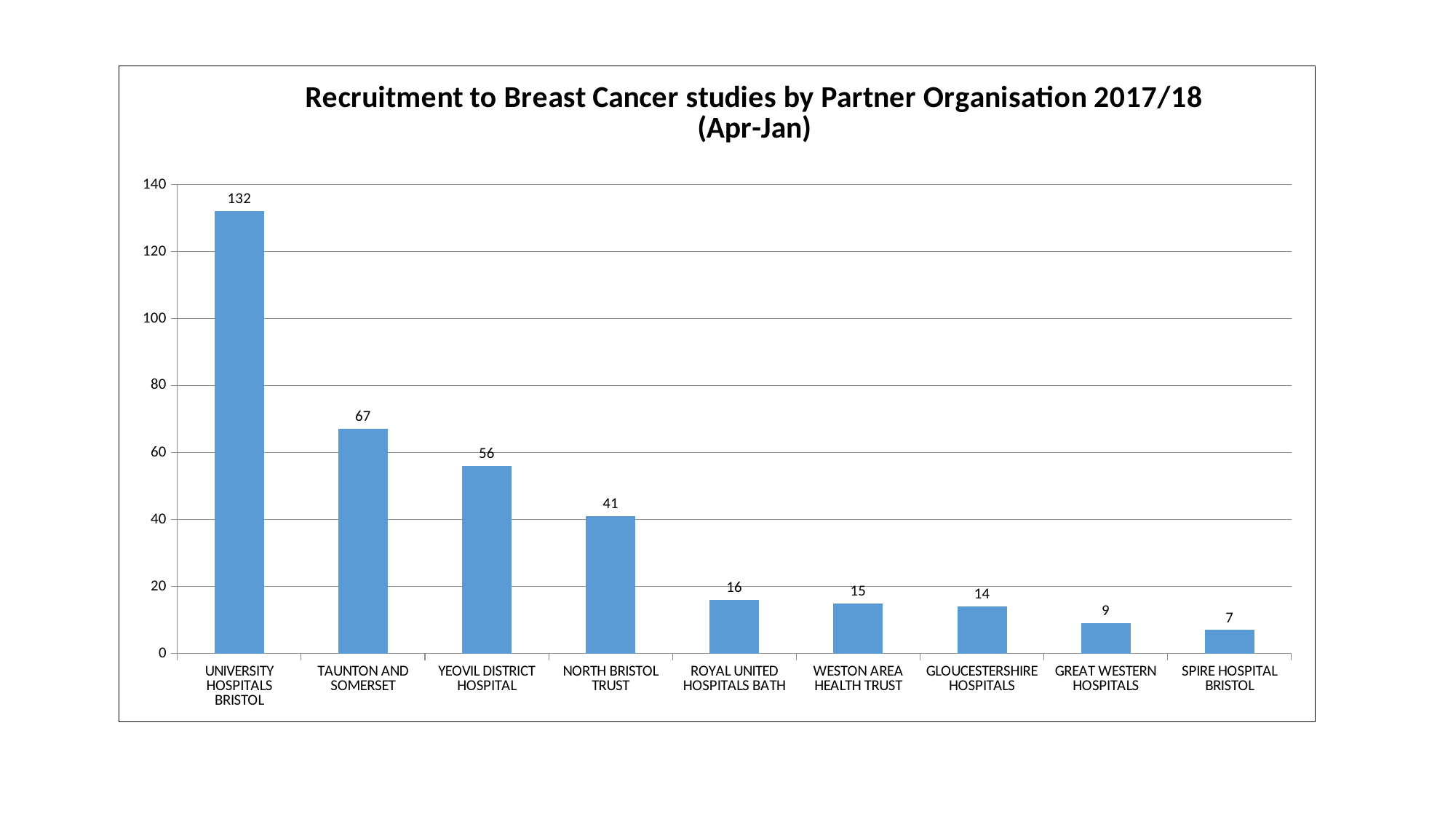
Is the value for Taunton and Somerset greater or less than 60? greater How many partner organisations are shown on the chart? 9 Which partner organisation has the lowest recruitment? Spire Hospital Bristol What is the recruitment value for University Hospitals Bristol? 132 What is the recruitment value for North Bristol Trust? 41 What is the title of the chart? Recruitment to Breast Cancer studies by Partner Organisation 2017/18 (Apr-Jan) Which partner organisation has the highest recruitment? University Hospitals Bristol What is the recruitment value for Gloucestershire Hospitals? 14 Do the values rise or fall from left to right along the x axis? Fall Which has a larger recruitment value, Royal United Hospitals Bath or Great Western Hospitals? Royal United Hospitals Bath What is the difference between the recruitment values for Taunton and Somerset and Yeovil District Hospital? 11 What kind of chart is shown on the slide? Bar chart